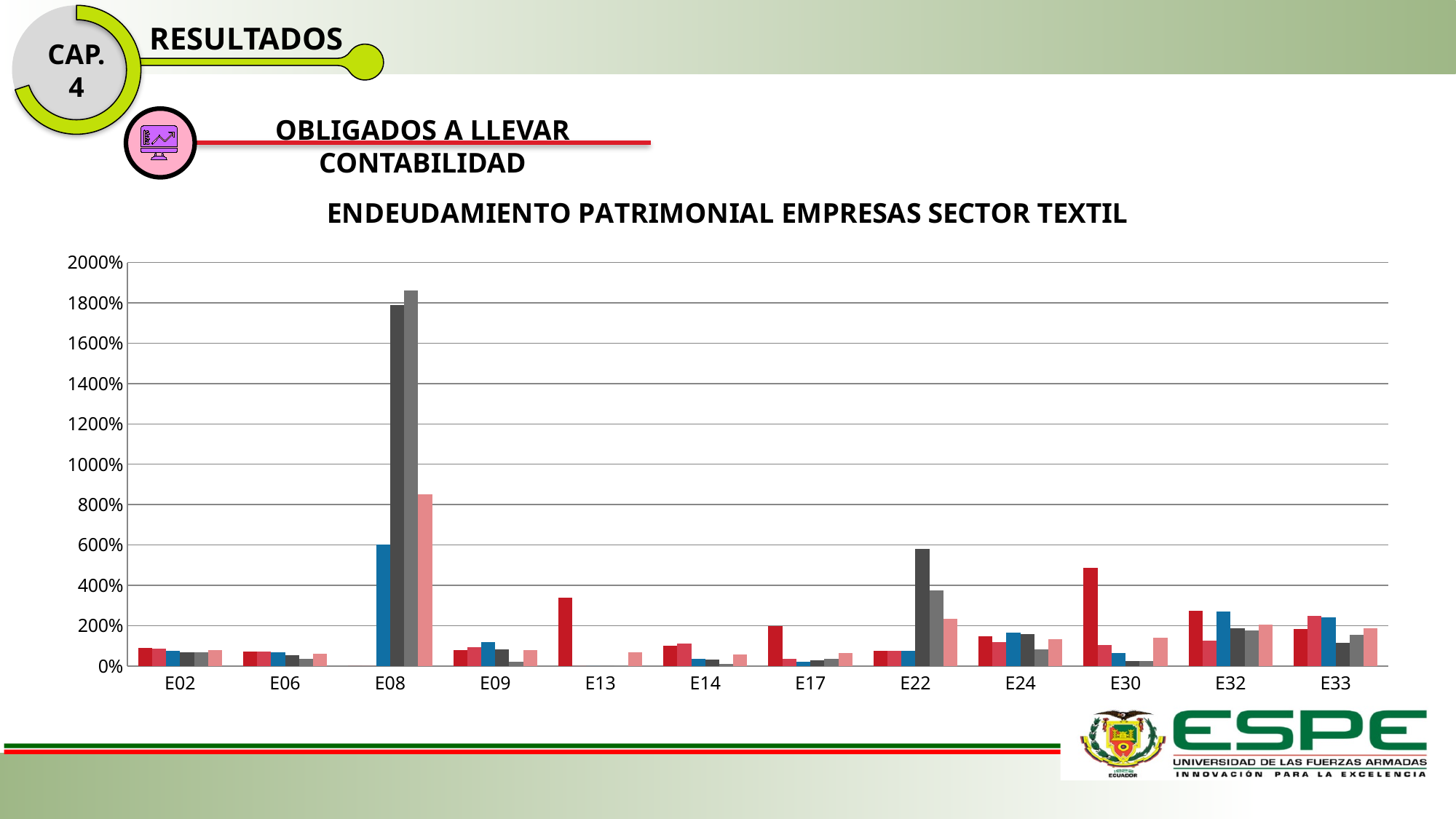
What kind of chart is shown on the slide? Bar chart Which category has a taller maximum bar, E08 or E22? E08 Is the pink bar at E08 greater or less than 1000%? less Is the blue bar at E08 greater or less than 400%? greater What is the title of the chart? ENDEUDAMIENTO PATRIMONIAL EMPRESAS SECTOR TEXTIL What is the highest value shown on the y axis of the chart? 2000% Is the tallest bar at E08 greater or less than 1800%? greater Which company category contains the tallest bar in the chart? E08 How many company categories are shown along the x axis of the chart? 12